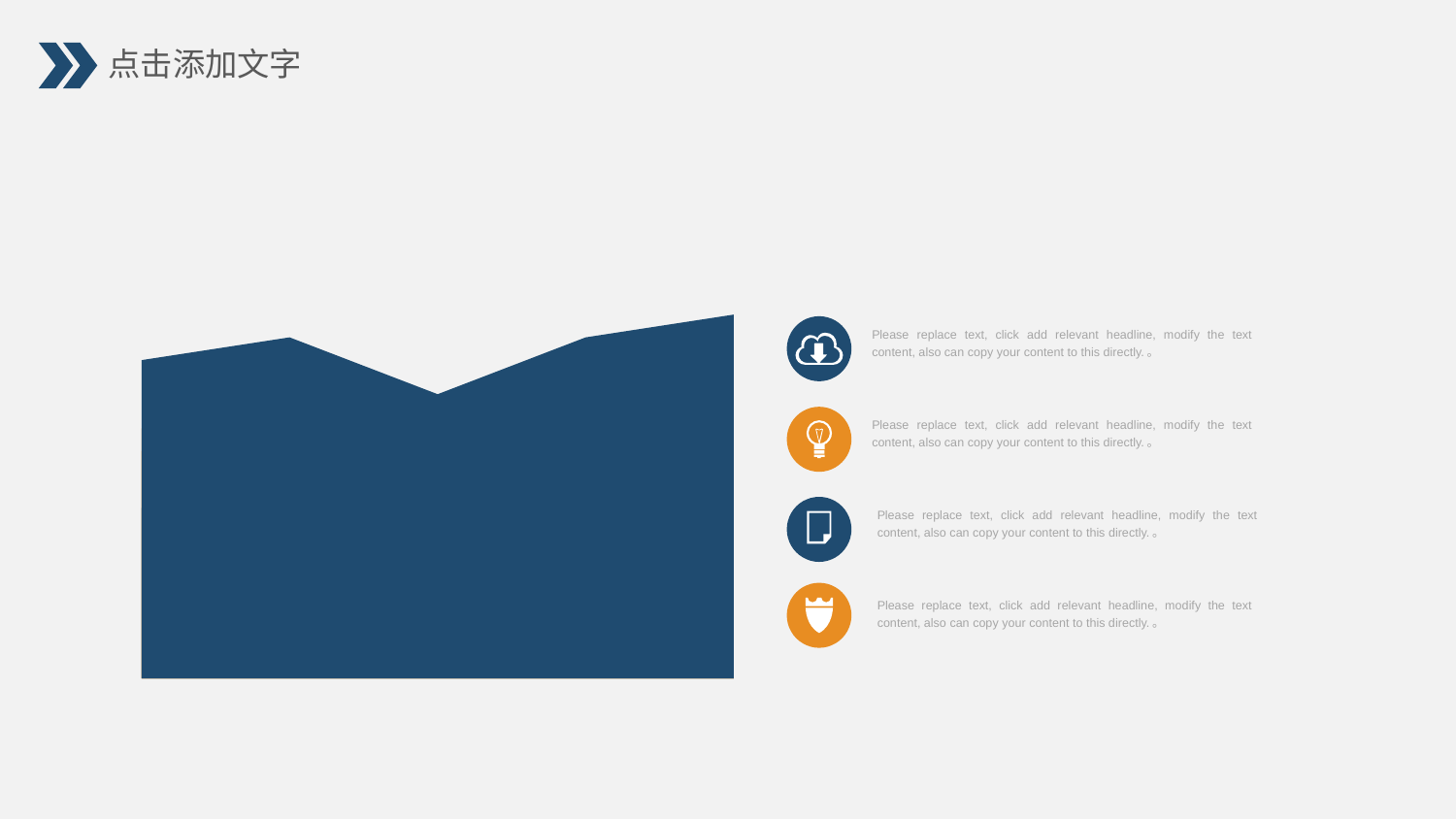
How many data points does the area chart's outline have? 5 Which data point of the area chart is the highest? the last (rightmost) point Between the third and fifth points, does the area chart rise or fall? rise What kind of chart is shown on the left of the slide? area chart Which data point of the area chart is the lowest? the third (middle) point Does the chart display any axis labels or data labels? No What colour is the filled area of the chart? dark blue Is the last point of the area chart higher or lower than the first point? higher Between the second and third points, does the area chart rise or fall? fall